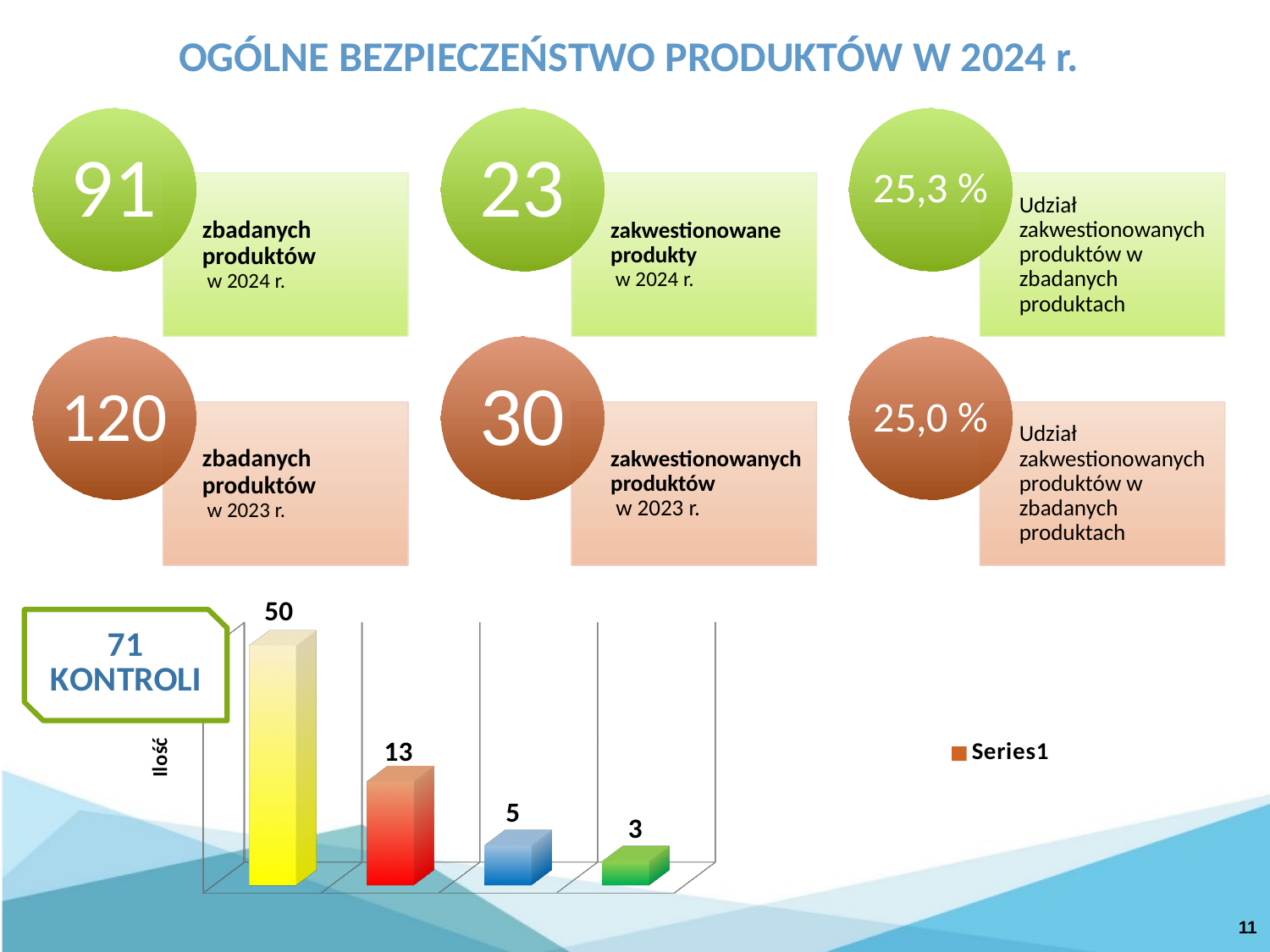
Which is larger in the chart, the red bar or the blue bar? The red bar What is the difference between the yellow bar and the red bar in the chart? 37 How many series does the chart legend list? 1 What is the label on the vertical axis of the chart? Ilość Which bar in the chart has the lowest value? The green bar (3) Which bar in the chart has the highest value? The yellow bar (50) What is the value shown on the yellow bar in the chart? 50 What kind of chart is shown at the bottom of the slide? Bar chart What is the value shown on the green bar in the chart? 3 What is the value shown on the red bar in the chart? 13 How many bars are plotted in the chart? 4 Do the bar values rise or fall from left to right in the chart? Fall